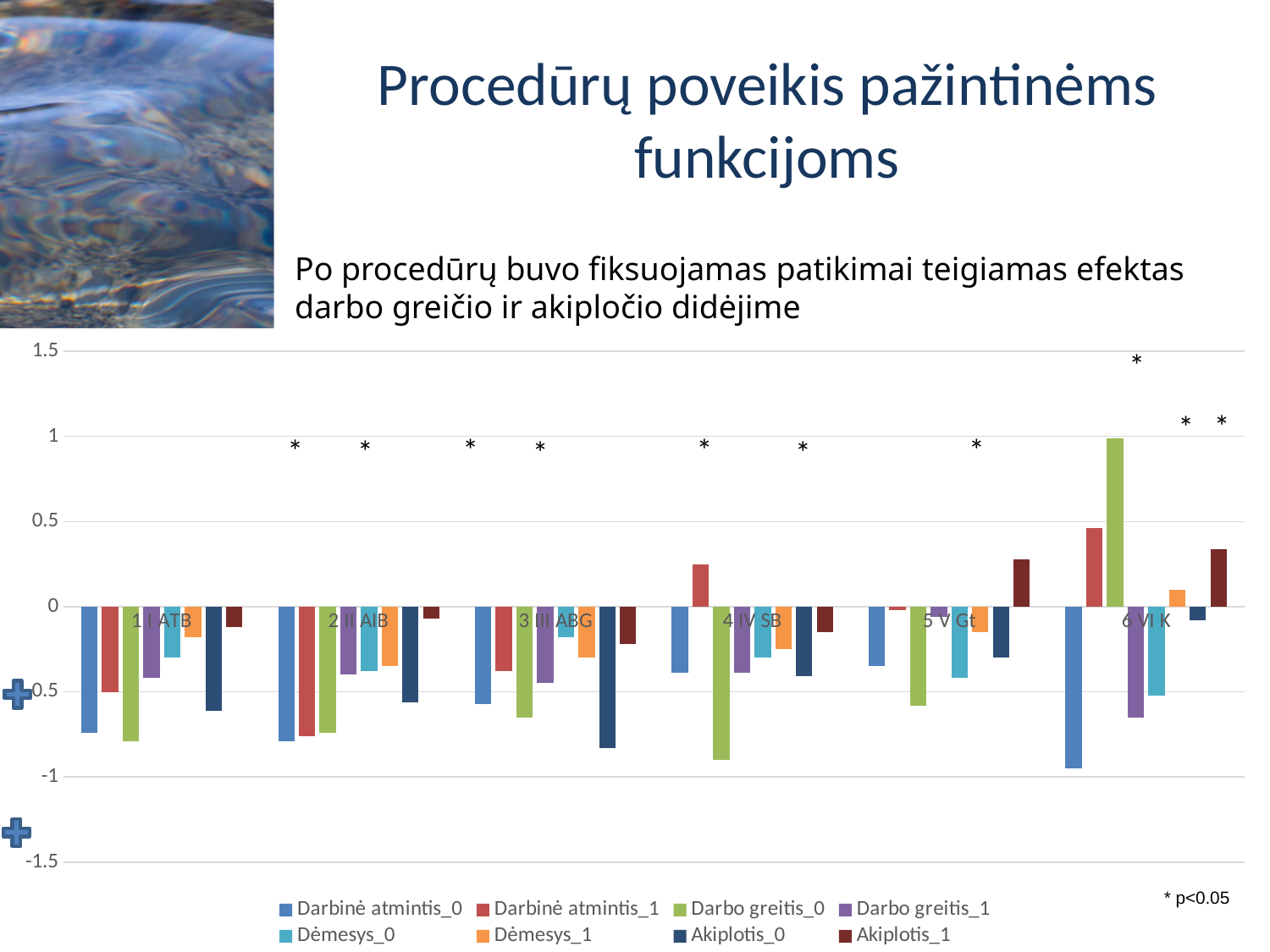
For 1 I ATB, which is larger: Dėmesys_0 or Darbinė atmintis_0? Dėmesys_0 Which series has the highest value in the whole chart? Darbo greitis_0 Is the value of Akiplotis_1 for 6 VI K greater or less than 0.5? less Is the value of Darbo greitis_0 for 6 VI K greater or less than 0.5? greater What kind of chart is shown on the slide? bar chart For 6 VI K, which is larger: Darbo greitis_0 or Darbinė atmintis_1? Darbo greitis_0 What does the asterisk footnote below the chart indicate? * p<0.05 Is the value of Akiplotis_0 for 3 III ABG greater or less than -0.5? less In which category does the Darbo greitis_0 series reach its highest value? 6 VI K How many categories are shown along the x axis of the chart? 6 How many series does the chart legend list? 8